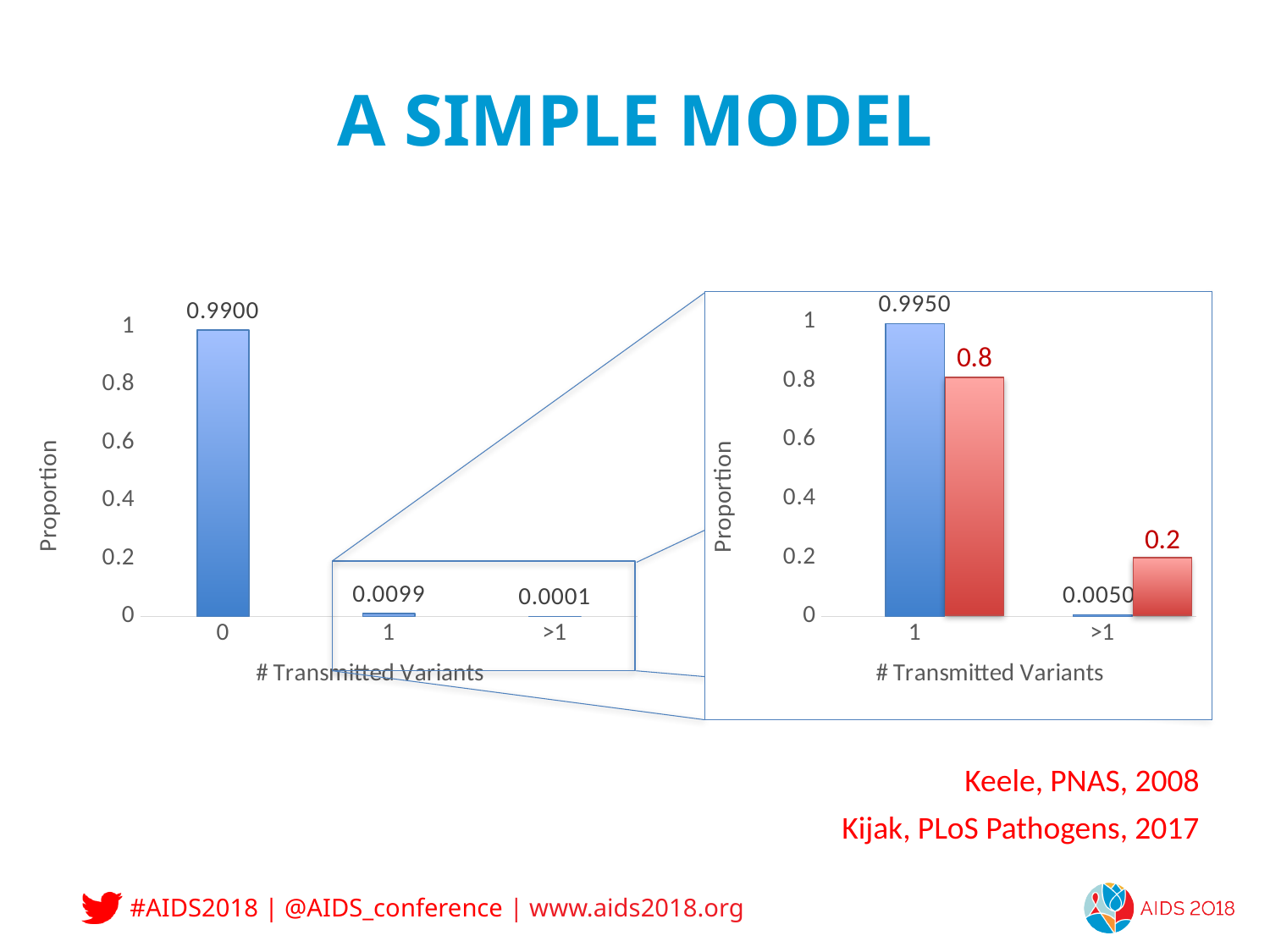
In the right (inset) chart, what is the value of the red bar for >1 transmitted variants? 0.2 In the right (inset) chart, which is larger for >1 transmitted variants: the blue bar or the red bar? the red bar What type of chart is the left chart? bar chart In the right (inset) chart, what is the value of the red bar for 1 transmitted variant? 0.8 In the right (inset) chart, what is the value of the blue bar for 1 transmitted variant? 0.9950 In the left chart, which category has the lowest proportion? >1 In the left chart, what is the difference between the proportions for 0 and 1 transmitted variants? 0.9801 In the left chart, which category has the highest proportion? 0 In the left chart, what is the proportion for >1 transmitted variants? 0.0001 In the left chart, what is the proportion for 1 transmitted variant? 0.0099 In the left chart, how many categories are shown on the x axis? 3 In the left chart, what is the proportion for 0 transmitted variants? 0.9900